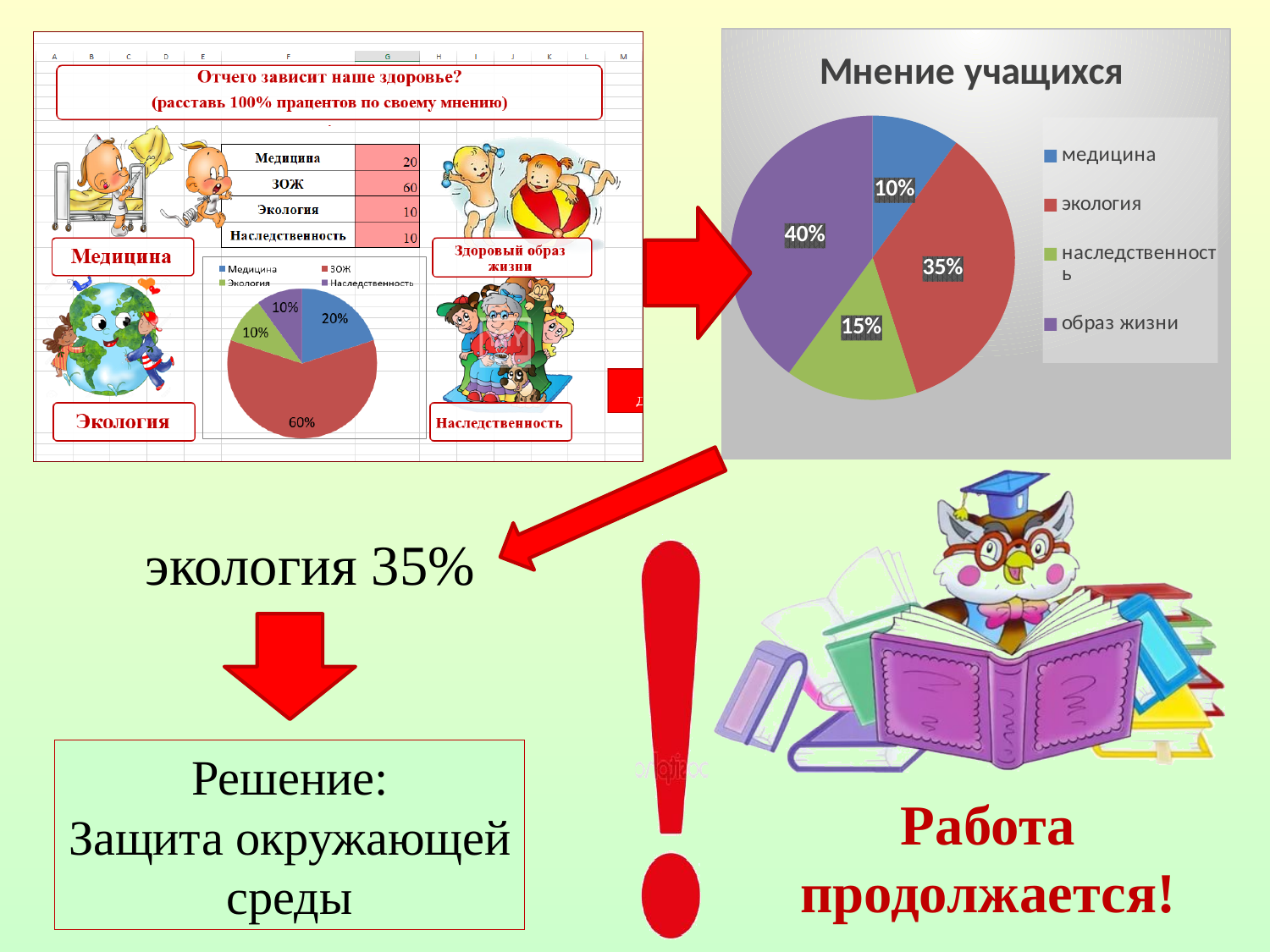
In the pie chart titled "Мнение учащихся", which category has the largest slice? образ жизни In the pie chart titled "Мнение учащихся", what share is labelled for образ жизни? 40% In the pie chart inside the spreadsheet screenshot on the left, what share is labelled for Медицина? 20% In the pie chart inside the spreadsheet screenshot on the left, what share is labelled for ЗОЖ? 60% In the pie chart titled "Мнение учащихся", which is larger: the share for экология or the share for наследственность? экология What kind of chart is shown under the title "Мнение учащихся"? pie chart In the pie chart titled "Мнение учащихся", which category has the smallest slice? медицина In the pie chart titled "Мнение учащихся", what is the difference between the shares for образ жизни and экология? 5% In the pie chart titled "Мнение учащихся", what share is labelled for экология? 35% In the pie chart inside the spreadsheet screenshot on the left, which category has the largest slice? ЗОЖ In the pie chart titled "Мнение учащихся", what share is labelled for наследственность? 15% In the pie chart titled "Мнение учащихся", how many entries does the legend list? 4